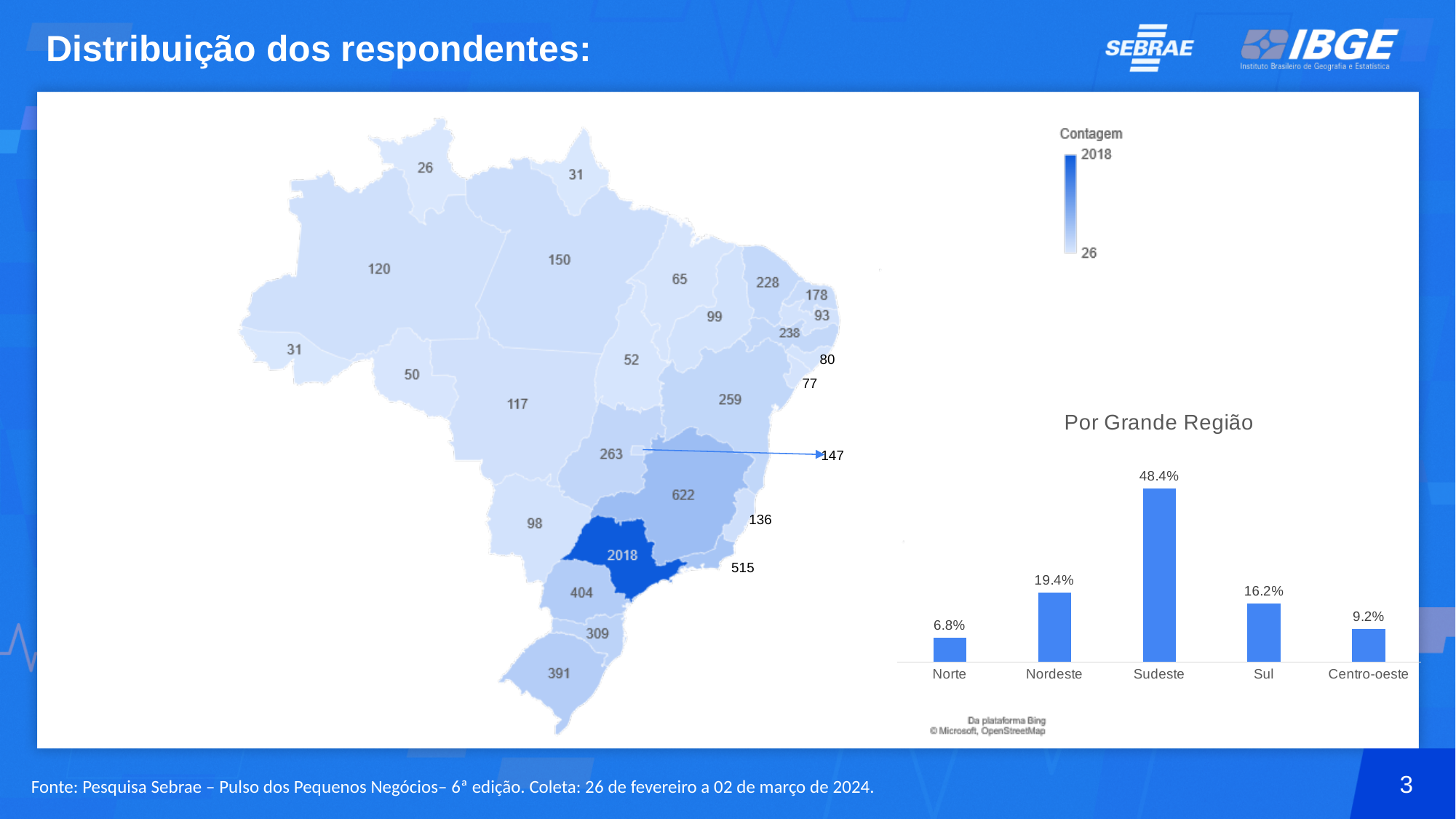
In the 'Por Grande Região' bar chart, what is the value for Centro-oeste? 9.2% What kind of chart is the 'Por Grande Região' chart on the right of the slide? bar chart How many regions are shown in the 'Por Grande Região' bar chart? 5 In the 'Por Grande Região' bar chart, which is larger, the value for Nordeste or the value for Centro-oeste? Nordeste In the 'Por Grande Região' bar chart, which region has the highest value? Sudeste On the map on the left, what is the lowest count shown for a state? 26 In the 'Por Grande Região' bar chart, what is the value for Norte? 6.8% On the map on the left, what is the highest count shown for a state? 2018 In the 'Por Grande Região' bar chart, what is the value for Sudeste? 48.4% In the 'Por Grande Região' bar chart, what is the difference between the values for Nordeste and Sul? 3.2% What is the title of the chart on the right side of the slide? Por Grande Região In the 'Por Grande Região' bar chart, which region has the lowest value? Norte